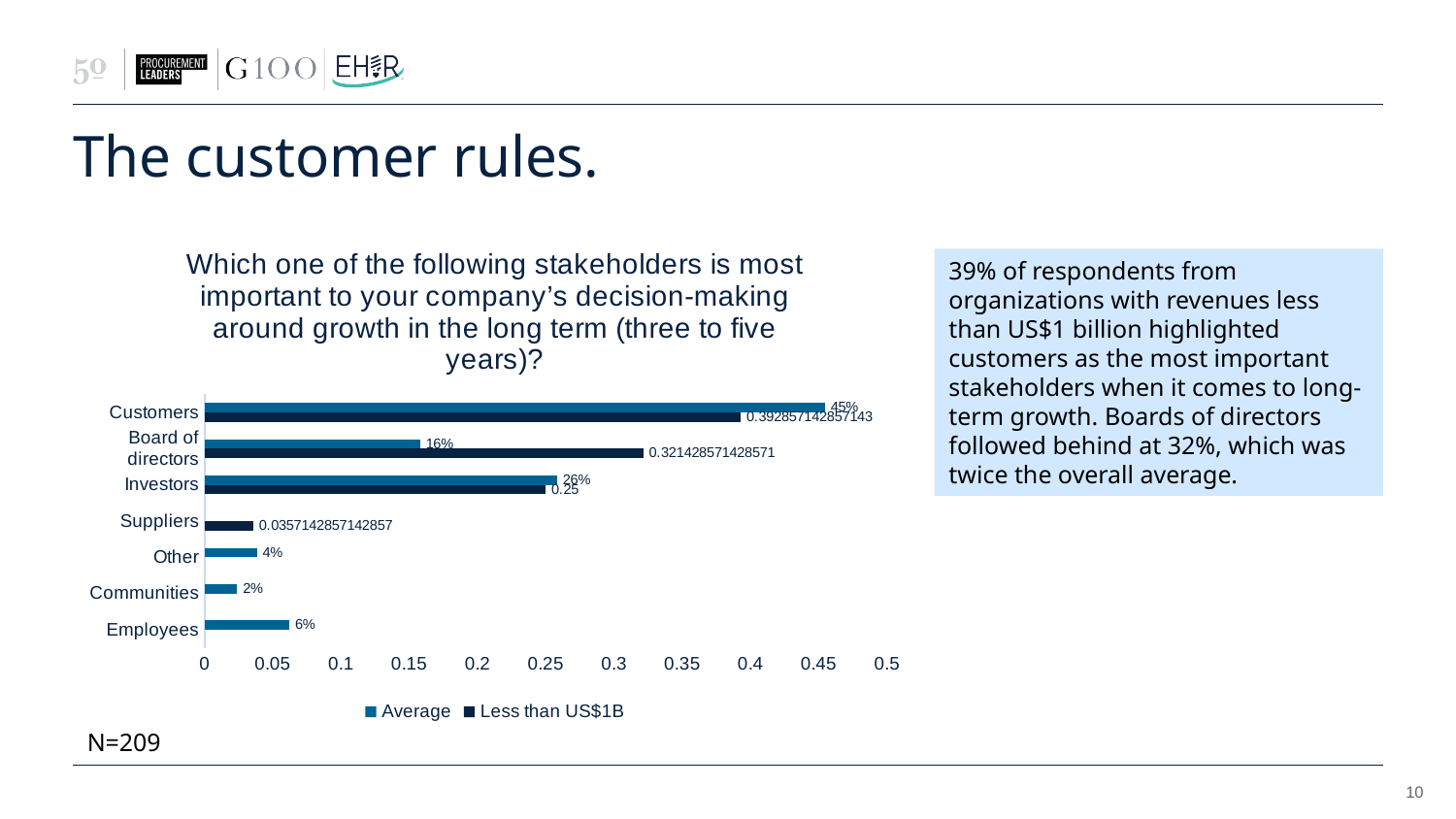
What is the Less than US$1B value for Investors? 0.25 How many stakeholder categories are plotted on the chart? 7 What is the difference between the Average values for Employees and Communities? 4% Which category has the highest Average value? Customers For Board of directors, which is larger: the Average value or the Less than US$1B value? Less than US$1B What kind of chart is shown on the slide? Bar chart Is the Less than US$1B value for Customers greater or less than 0.35? greater Which category has the highest Less than US$1B value? Customers What is the Less than US$1B value for Board of directors? 0.321428571428571 What is the Average value for Customers? 45% How many series does the chart legend list? 2 What is the Average value for Board of directors? 16%